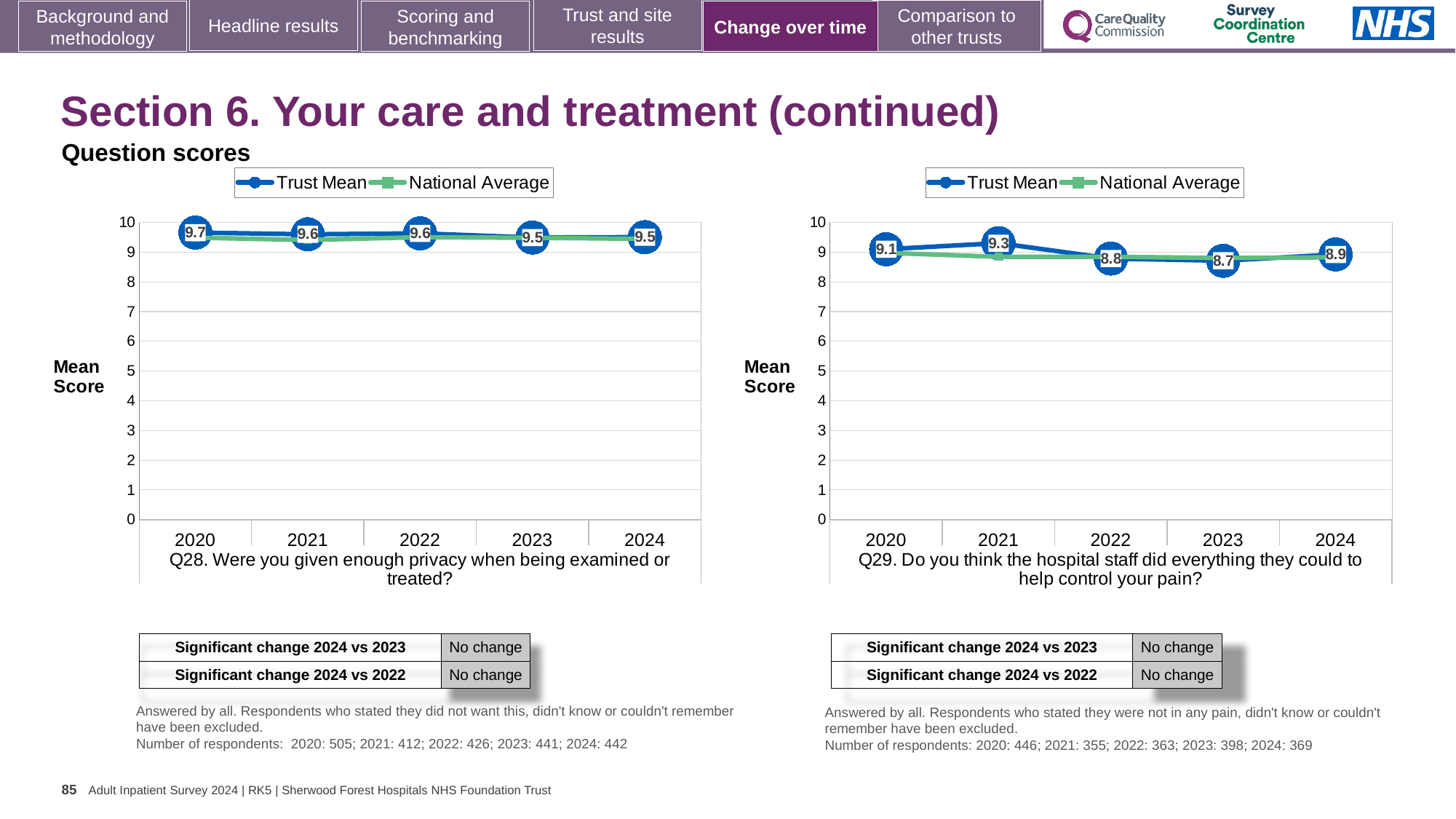
In the Q29 chart (right), what is the Trust Mean score for 2023? 8.7 In the Q29 chart (right), is the National Average for 2020 greater or less than 8? greater How many series does the legend of the Q29 chart (right) list? 2 In the Q29 chart (right), which year has the highest Trust Mean score? 2021 In the Q29 chart (right), which year has the lowest Trust Mean score? 2023 In the Q28 chart (left), what is the Trust Mean score for 2020? 9.7 How many years are shown on the x axis of the Q28 chart (left)? 5 What type of chart is the Q28 chart (left)? Line chart In the Q29 chart (right), what is the difference between the Trust Mean scores for 2021 and 2023? 0.6 In the Q28 chart (left), what is the Trust Mean score for 2024? 9.5 In the Q28 chart (left), which is larger, the Trust Mean score for 2020 or for 2023? 2020 In the Q29 chart (right), what is the Trust Mean score for 2021? 9.3